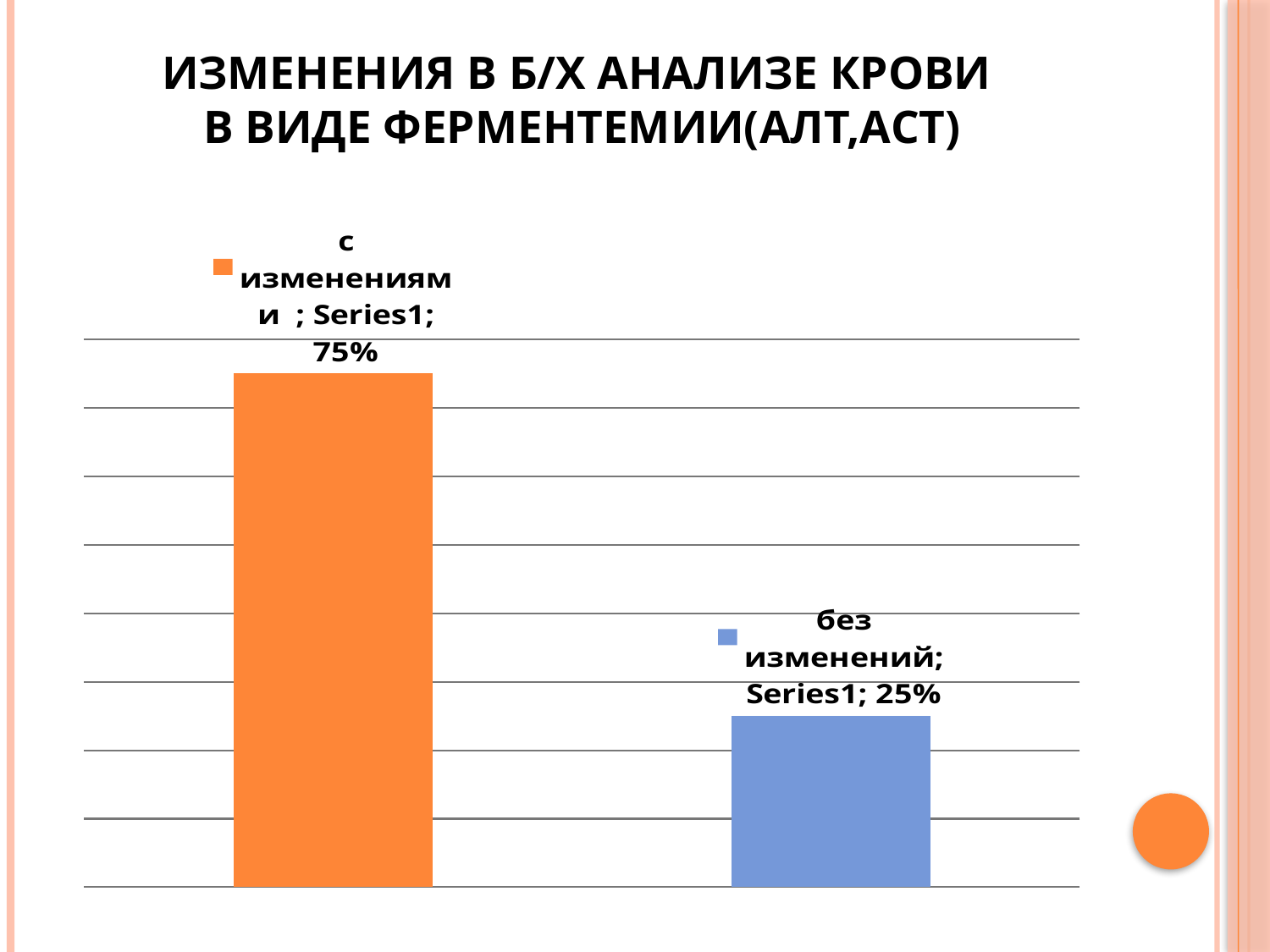
Which category has the lowest value? без изменений What is the value for the category "с изменениями"? 75% What kind of chart is shown on the slide? bar chart Which is larger: the value for "с изменениями" or for "без изменений"? с изменениями What colour is the bar for "без изменений"? blue Which category has the highest value? с изменениями What is the difference between the values for "с изменениями" and "без изменений"? 50% What is the total of the two plotted values? 100% What colour is the bar for "с изменениями"? orange How many categories are plotted in the chart? 2 What is the value for the category "без изменений"? 25%